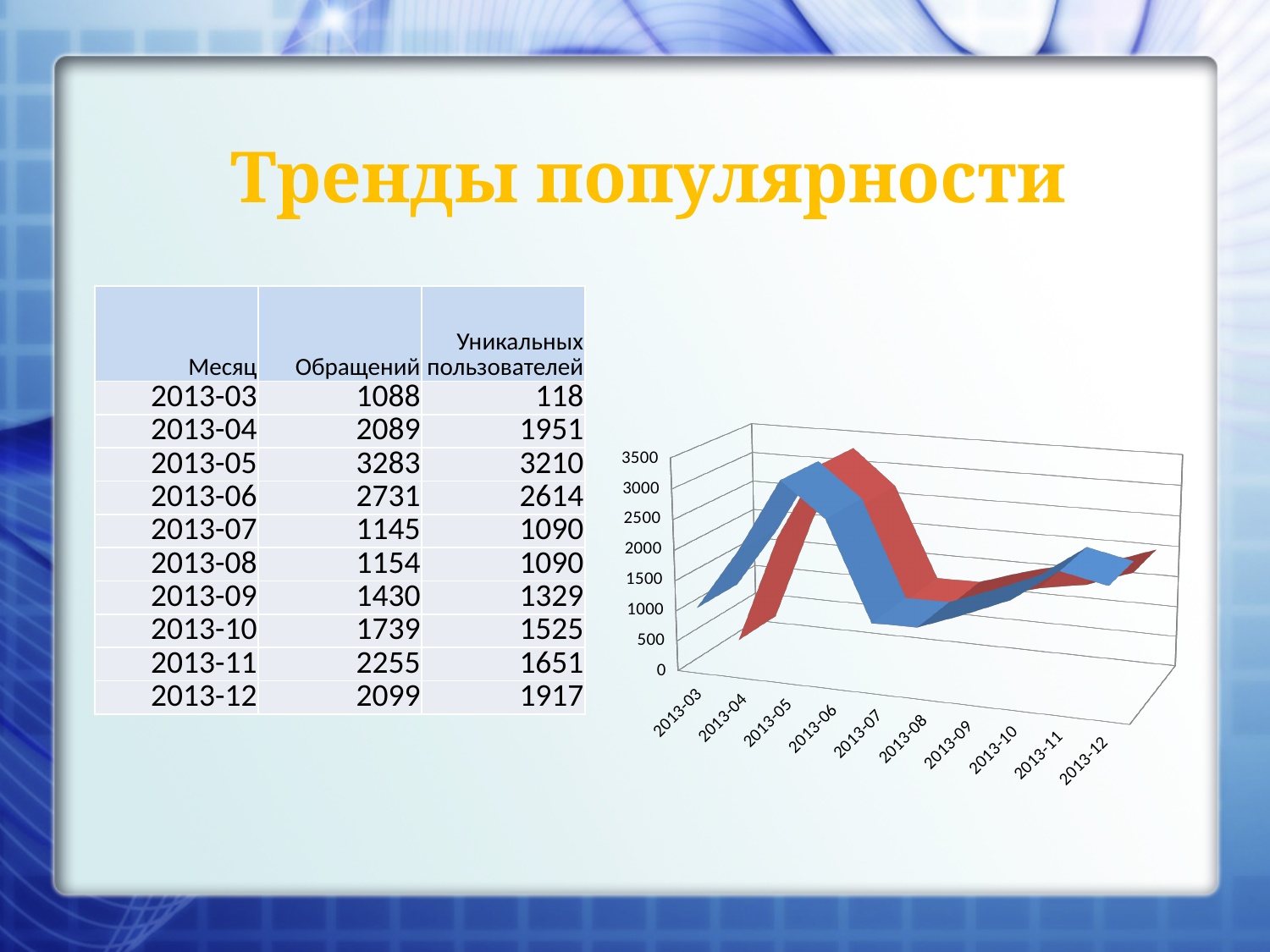
What is the value of Обращений for 2013-05? 3283 Which month has the lowest value of Уникальных пользователей? 2013-03 What is the value of Уникальных пользователей for 2013-03? 118 What is the title of the slide containing the chart? Тренды популярности What is the difference between Обращений and Уникальных пользователей for 2013-05? 73 Which month has the larger value of Обращений, 2013-11 or 2013-12? 2013-11 What kind of chart is shown on the slide? line chart Which month has the highest value of Обращений? 2013-05 How many months are shown along the x axis of the chart? 10 How many data series are plotted in the chart? 2 Do the values in the chart rise or fall from 2013-05 to 2013-07? fall Is the peak value of the chart at 2013-05 greater or less than 3000? greater